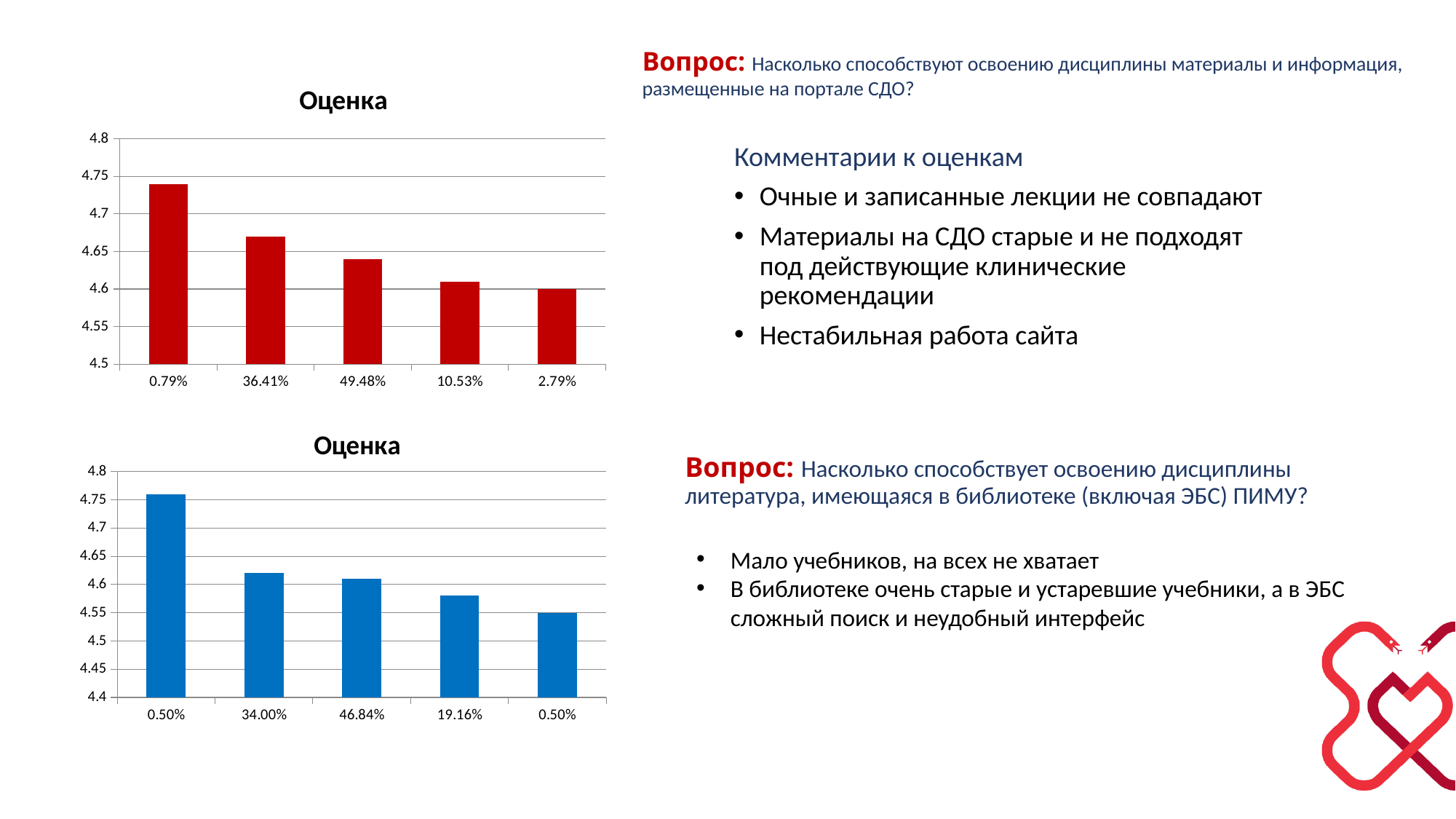
What type of chart is the bottom chart on the slide? bar chart In the top chart, is the value for 0.79% greater or less than 4.7? greater How many bars does the bottom chart show? 5 In the top chart, do the values rise or fall from left to right along the x axis? fall What is the title of the bottom chart? Оценка How many bars does the top chart show? 5 In the top chart, which category has the highest value? 0.79% What type of chart is the top chart on the slide? bar chart In the bottom chart, which is larger, the value for 34.00% or the value for 19.16%? 34.00% In the bottom chart, is the value for 19.16% greater or less than 4.6? less In the top chart, is the value for 36.41% greater or less than 4.65? greater In the top chart, which is larger, the value for 0.79% or the value for 36.41%? 0.79%